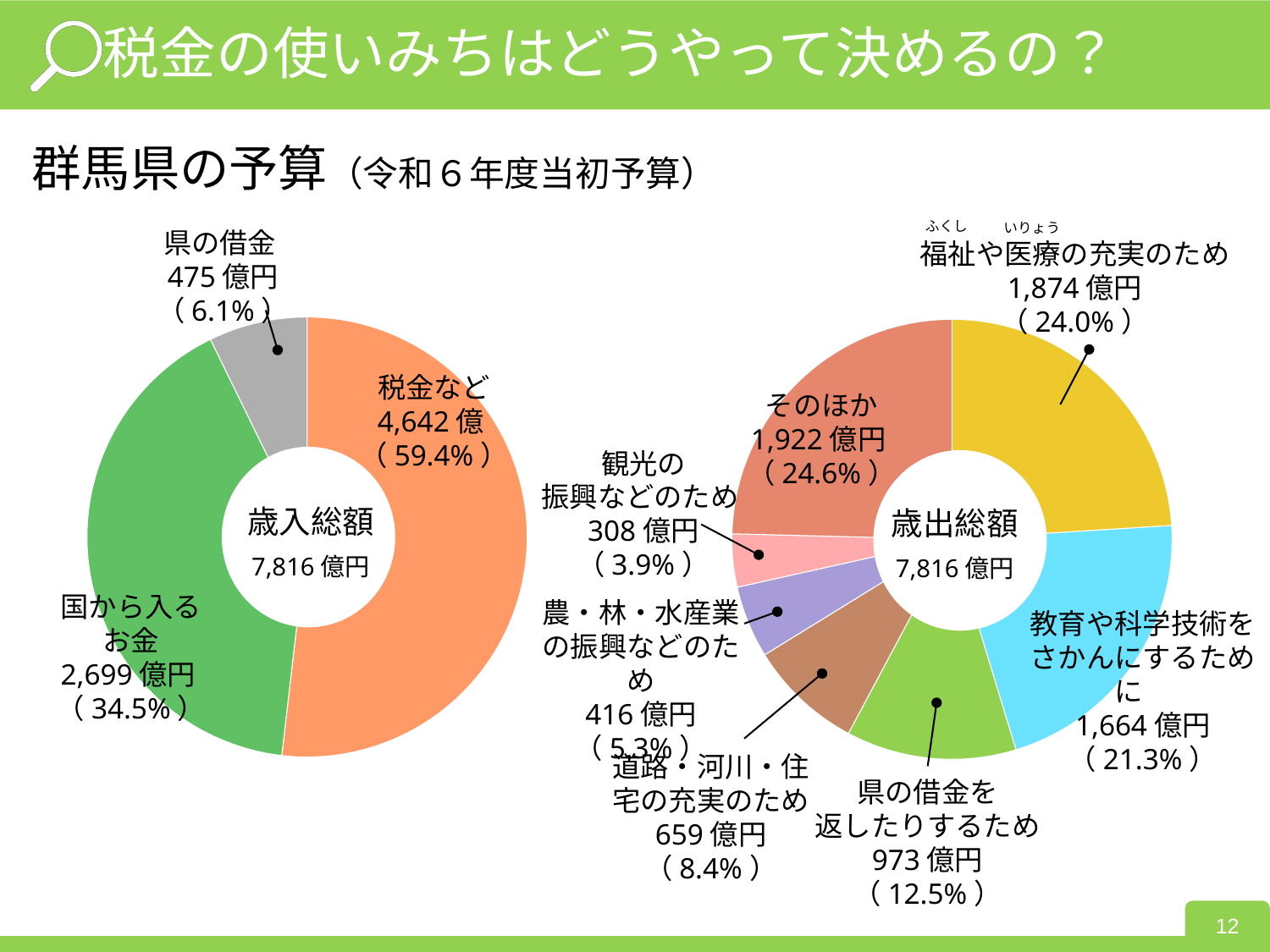
In the 歳入総額 chart on the left, which category is the smallest? 県の借金 In the 歳出総額 chart on the right, how many categories are shown? 7 In the 歳出総額 chart on the right, which is larger: 道路・河川・住宅の充実のため or 農・林・水産業の振興などのため? 道路・河川・住宅の充実のため In the 歳出総額 chart on the right, which category is the smallest? 観光の振興などのため In the 歳入総額 chart on the left, how many categories are shown? 3 In the 歳出総額 chart on the right, what share of the total is 県の借金を返したりするため? 12.5% In the 歳入総額 chart on the left, what is the value for 税金など? 4,642 億 In the 歳出総額 chart on the right, what is the value for 福祉や医療の充実のため? 1,874 億円 In the 歳入総額 chart on the left, what share of the total is 国から入るお金? 34.5% In the 歳入総額 chart on the left, what is the difference between 税金など and 国から入るお金 in 億円? 1,943 億円 In the 歳出総額 chart on the right, which category is the largest? そのほか What kind of chart is used for 歳出総額 on the right? Pie (donut) chart